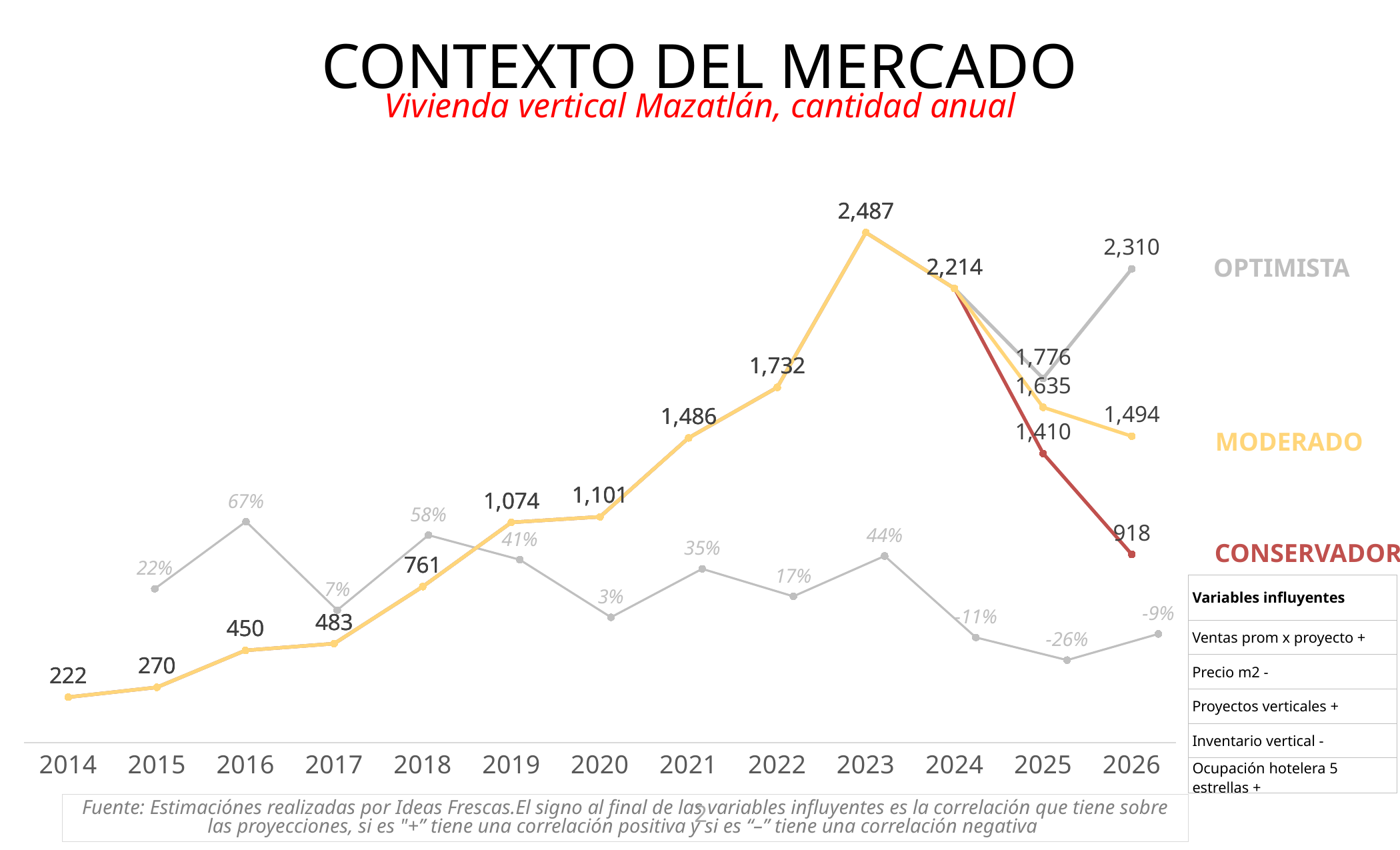
What is the 2025 value for the MODERADO scenario? 1,635 What is the difference between the 2023 value and the 2024 value? 273 What percentage growth is shown for 2016? 67% Which year has the highest value on the main line? 2023 What type of chart is shown on the slide? Line chart What is the value shown for 2023 on the chart? 2,487 How many years are shown on the x axis? 13 What is the 2026 value for the OPTIMISTA scenario? 2,310 Which is larger, the 2026 MODERADO value or the 2026 CONSERVADOR value? 2026 MODERADO (1,494) What percentage is shown for 2025 on the gray percentage line? -26% What is the 2026 value for the CONSERVADOR scenario? 918 What is the value shown for 2014 on the chart? 222